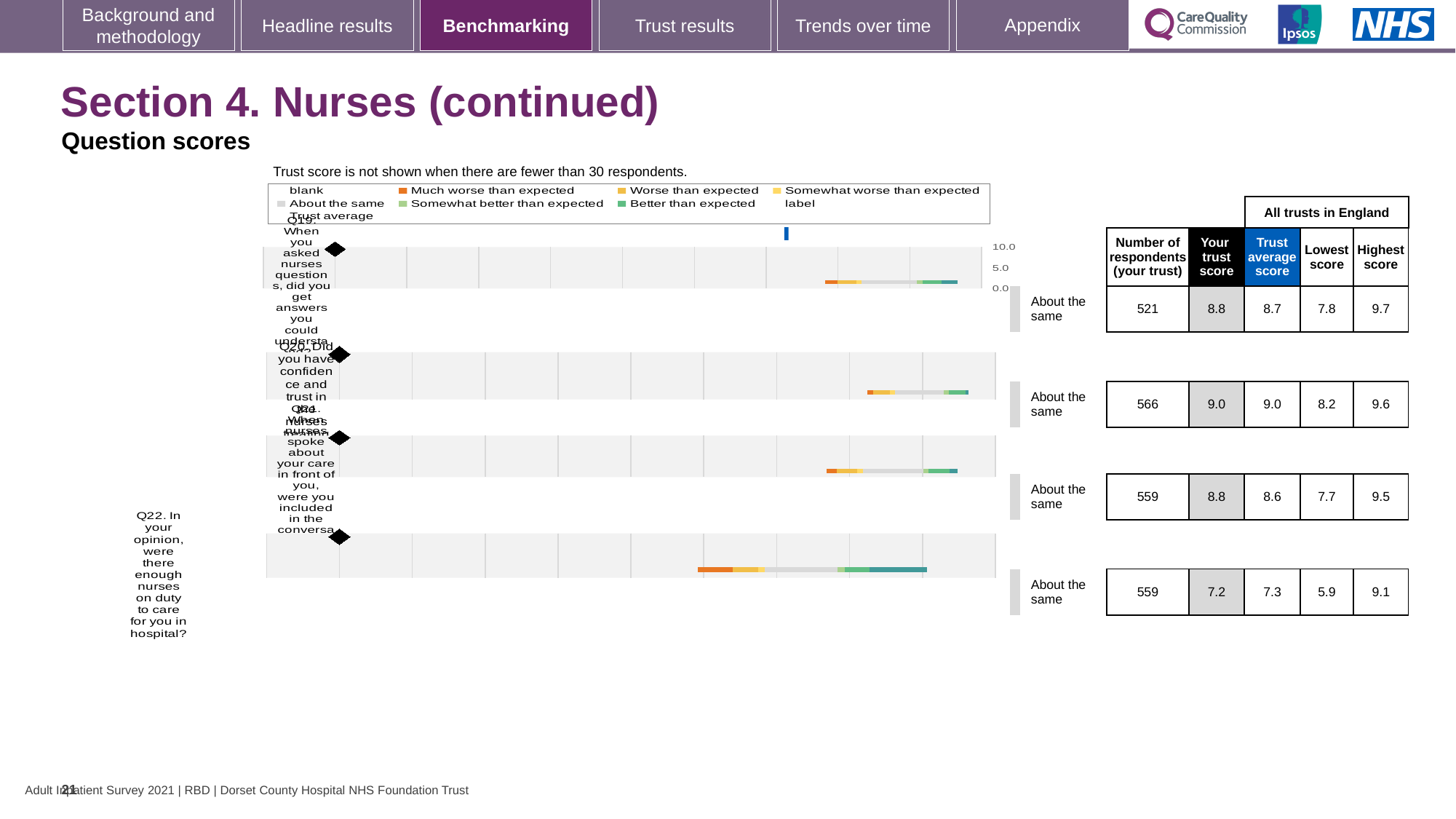
How many questions are shown in the chart? 4 How many respondents from your trust answered Q20 (did you have confidence and trust in the nurses)? 566 What benchmark category label is shown next to Q22? About the same What is the lowest score across all trusts in England for Q22? 5.9 What kind of chart is used to show the question scores? Bar chart For Q19, which is larger: 'Your trust score' or the trust average score? Your trust score For Q21, what is the difference between 'Your trust score' and the trust average score? 0.2 What is the 'Your trust score' for Q22 (were there enough nurses on duty to care for you in hospital)? 7.2 Which question has the highest 'Your trust score'? Q20 What is the highest score across all trusts in England for Q20? 9.6 Which question has the lowest 'Your trust score'? Q22 What is the trust average score for Q19 (when you asked nurses questions, did you get answers you could understand)? 8.7